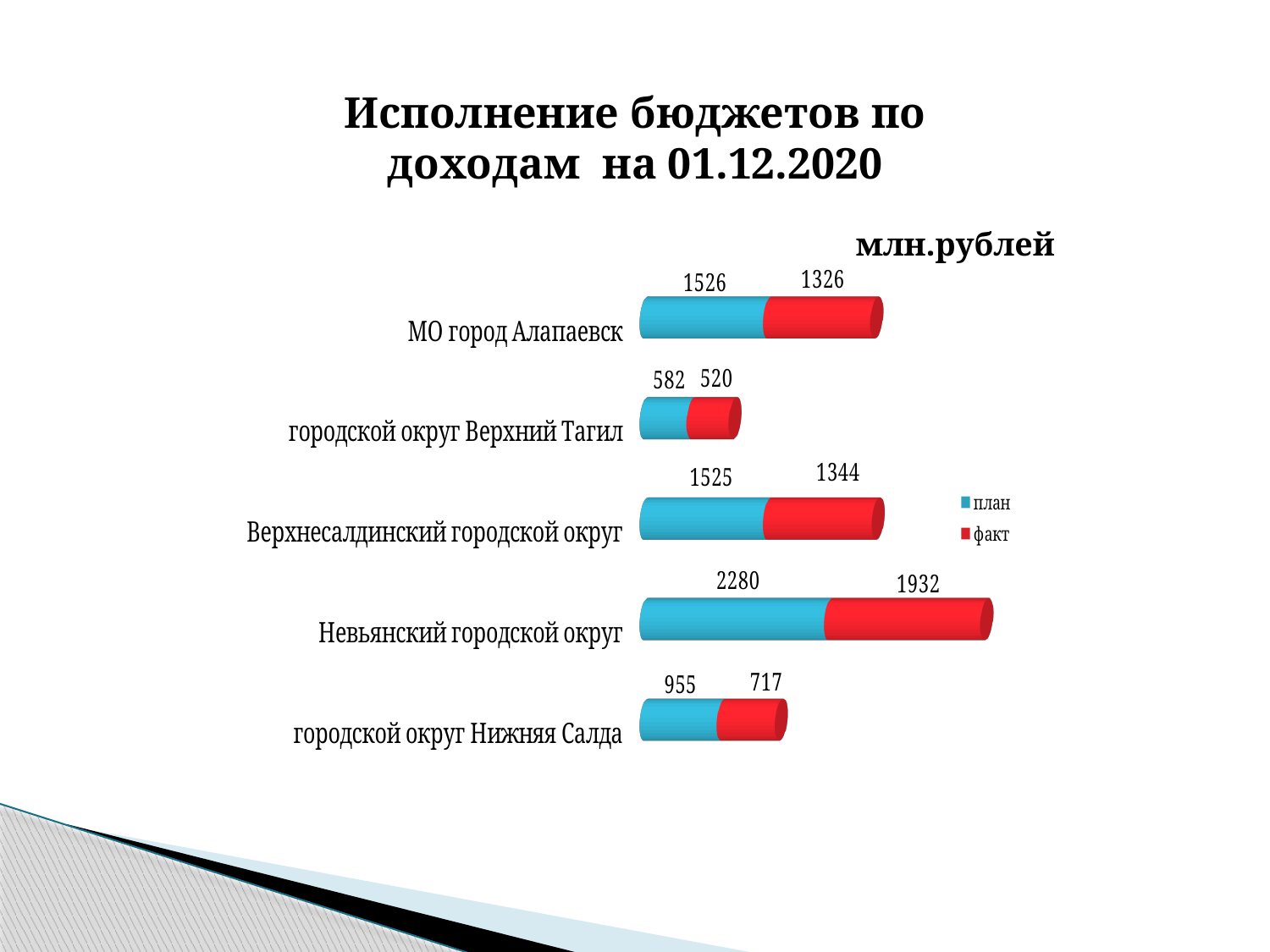
What is the план value for Невьянский городской округ? 2280 Which is larger: the факт value for Верхнесалдинский городской округ or the факт value for городской округ Нижняя Салда? Верхнесалдинский городской округ What is the факт value for городской округ Нижняя Салда? 717 How many categories are shown on the chart? 5 Which category has the highest план value? Невьянский городской округ What is the факт value for МО город Алапаевск? 1326 What kind of chart is shown on the slide? Bar chart What is the difference between план and факт for городской округ Верхний Тагил? 62 What is the total of the stacked bar for городской округ Нижняя Салда? 1672 How many series does the legend list? 2 Which category has the lowest факт value? городской округ Верхний Тагил What is the difference between план and факт for Невьянский городской округ? 348